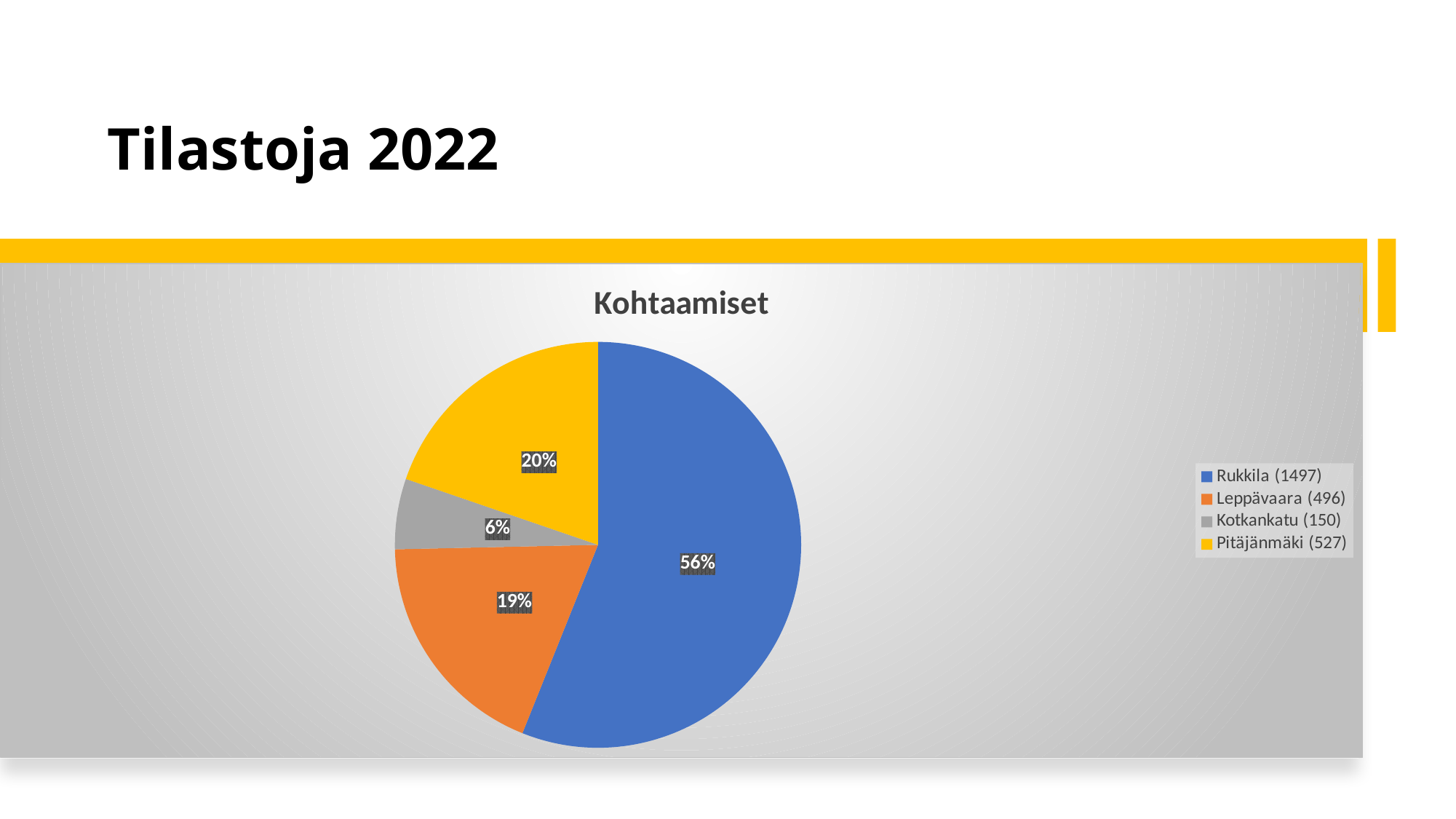
What colour is the Pitäjänmäki (527) slice? yellow What is the title of the chart? Kohtaamiset Which slice is the largest? Rukkila (1497) What share of the pie does Rukkila (1497) take? 56% How many slices does the pie chart have? 4 Which slice is the smallest? Kotkankatu (150) What is the difference in percentage points between the Rukkila (1497) share and the Pitäjänmäki (527) share? 36 What share of the pie does Leppävaara (496) take? 19% What share of the pie does Kotkankatu (150) take? 6% Which is larger, the share for Leppävaara (496) or the share for Kotkankatu (150)? Leppävaara (496) What kind of chart is shown on the slide? pie chart